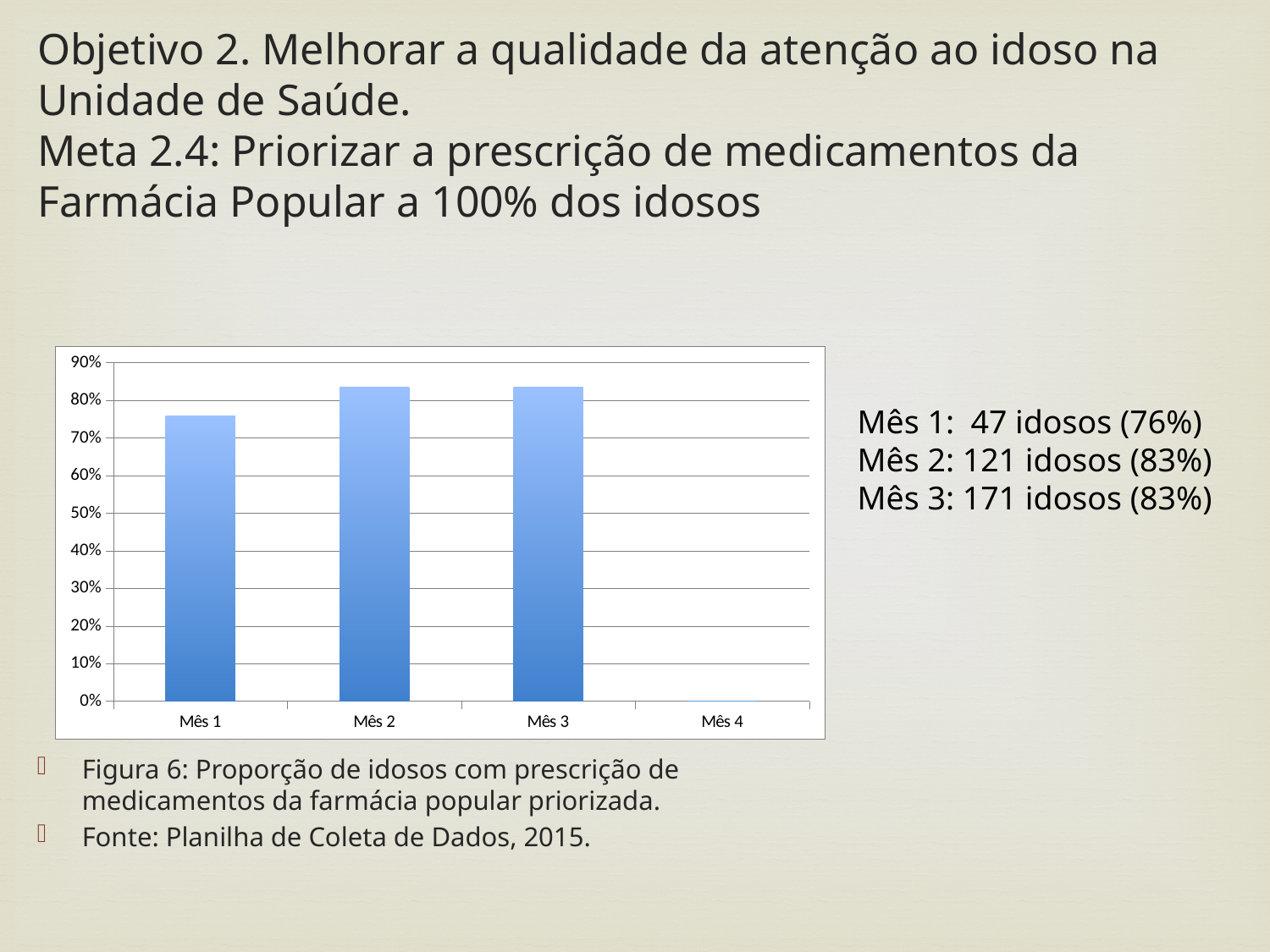
Which month has the lowest value in the chart? Mês 4 What is the difference in percentage points between Mês 2 and Mês 1? 7 percentage points What is the figure number given in the caption below the chart? Figura 6 Which has the larger value, Mês 1 or Mês 2? Mês 2 What kind of chart is shown on the slide? bar chart What is the proportion shown for Mês 2? 83% How many month categories are shown on the x axis of the chart? 4 Is the value for Mês 2 greater or less than 80%? greater What is the proportion of elderly with prioritized Farmácia Popular prescriptions in Mês 1? 76% Is the value for Mês 1 greater or less than 70%? greater Does the value rise or fall from Mês 1 to Mês 2? rise What is the proportion shown for Mês 3? 83%